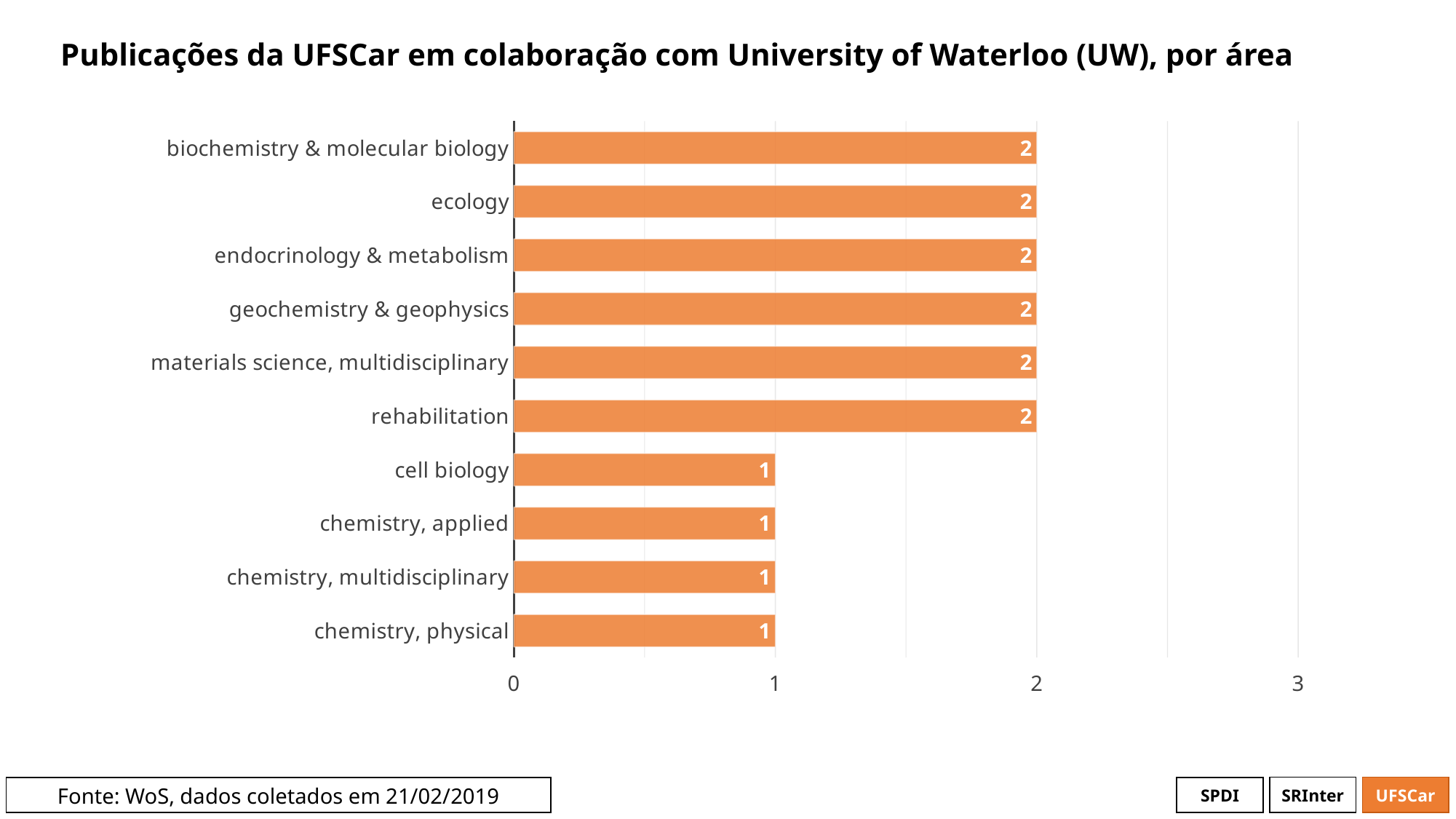
What is the value for chemistry, physical? 1 What is the value for ecology? 2 What is the value for rehabilitation? 2 What is the title of the chart? Publicações da UFSCar em colaboração com University of Waterloo (UW), por área How many categories have a value of 1? 4 How many categories have a value of 2? 6 What kind of chart is shown on the slide? bar chart Which is larger, the value for materials science, multidisciplinary or the value for chemistry, multidisciplinary? materials science, multidisciplinary What is the highest value shown on the x axis? 3 What is the difference between the values for geochemistry & geophysics and chemistry, applied? 1 What is the value for cell biology? 1 How many categories are shown in the chart? 10